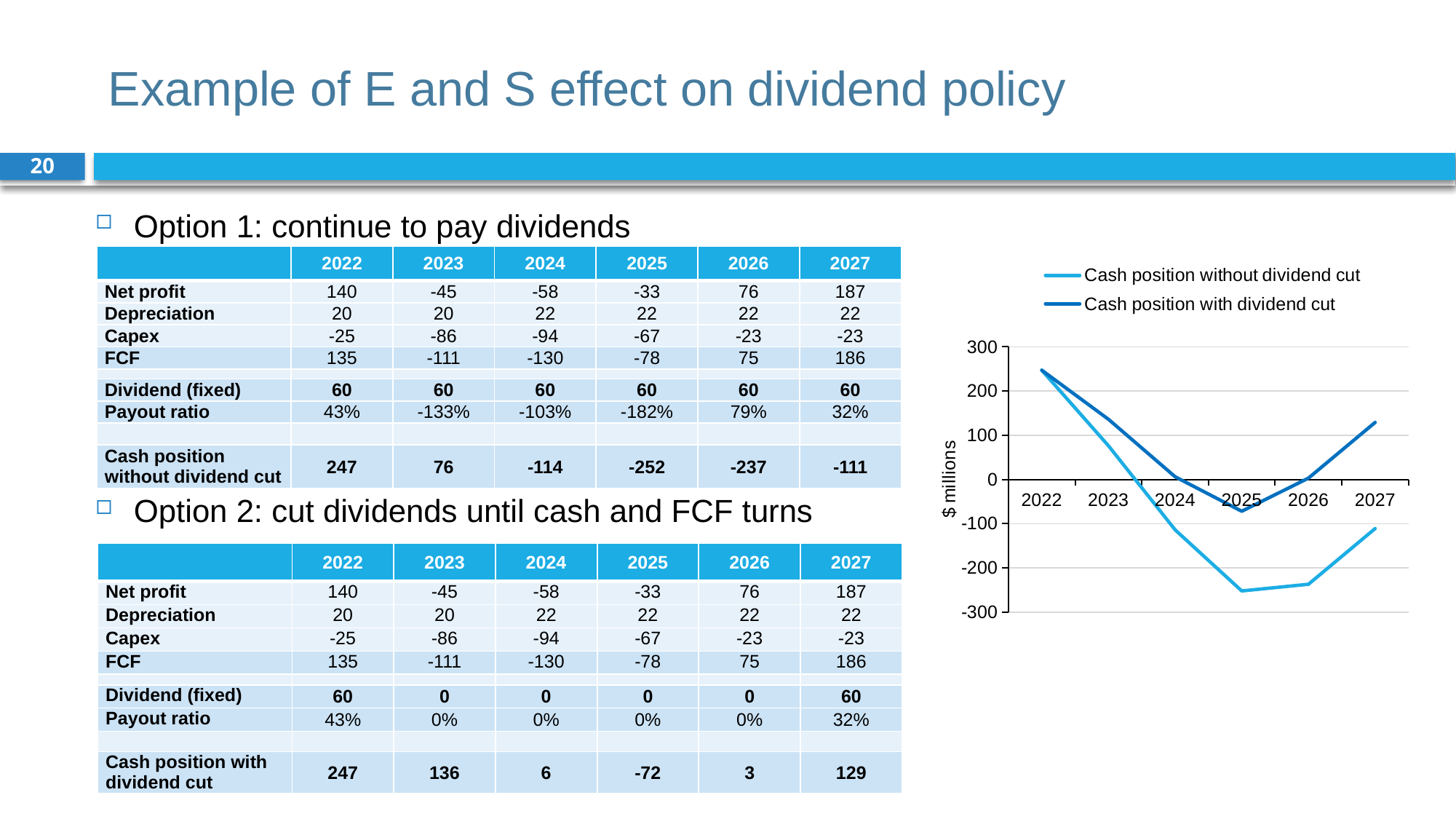
Is the value for 'Cash position with dividend cut' in 2027 greater or less than 100? greater In which year is the 'Cash position with dividend cut' line at its highest? 2022 What is the difference between 'Cash position with dividend cut' and 'Cash position without dividend cut' in 2027? 240 How many years are plotted along the x axis of the chart? 6 Is the value for 'Cash position without dividend cut' in 2025 greater or less than -200? less Does the 'Cash position without dividend cut' line rise or fall from 2022 to 2025? fall How many series does the chart's legend list? 2 What is the value of 'Cash position with dividend cut' in 2025? -72 In which year is the 'Cash position without dividend cut' line at its lowest? 2025 What kind of chart is shown on the slide? line chart What is the label on the chart's vertical axis? $ millions In 2024, which series has the higher value: 'Cash position with dividend cut' or 'Cash position without dividend cut'? Cash position with dividend cut